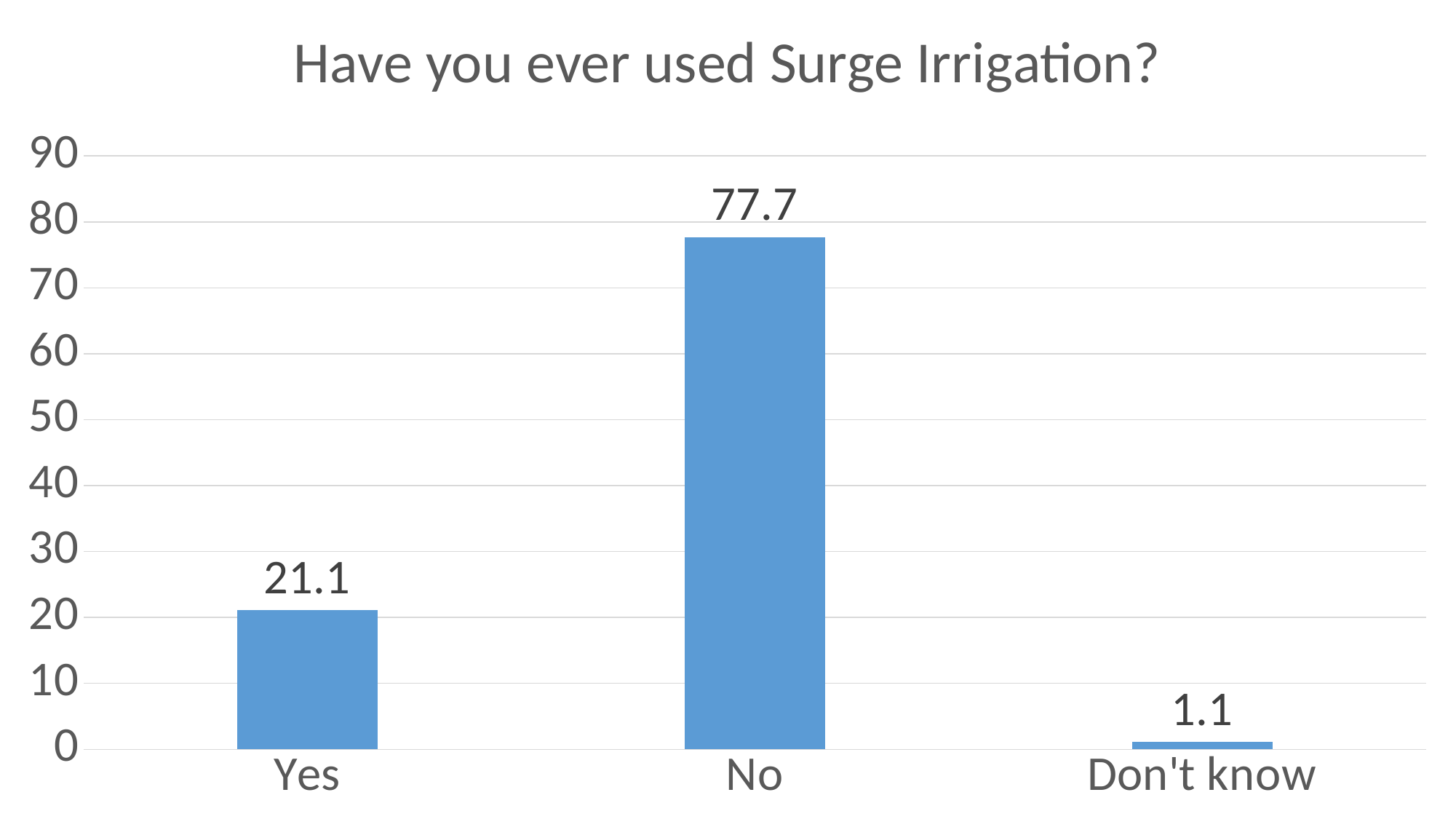
What is the difference between the values for "No" and "Yes"? 56.6 What is the value for "No"? 77.7 What is the difference between the values for "Yes" and "Don't know"? 20 How many categories are shown on the x axis? 3 What is the value for "Don't know"? 1.1 What is the title of the chart? Have you ever used Surge Irrigation? What kind of chart is shown on the slide? bar chart Which is larger, the value for "Yes" or the value for "No"? No What is the value for "Yes"? 21.1 Which category has the highest value? No Is the value for "Yes" greater or less than 30? less Which category has the lowest value? Don't know